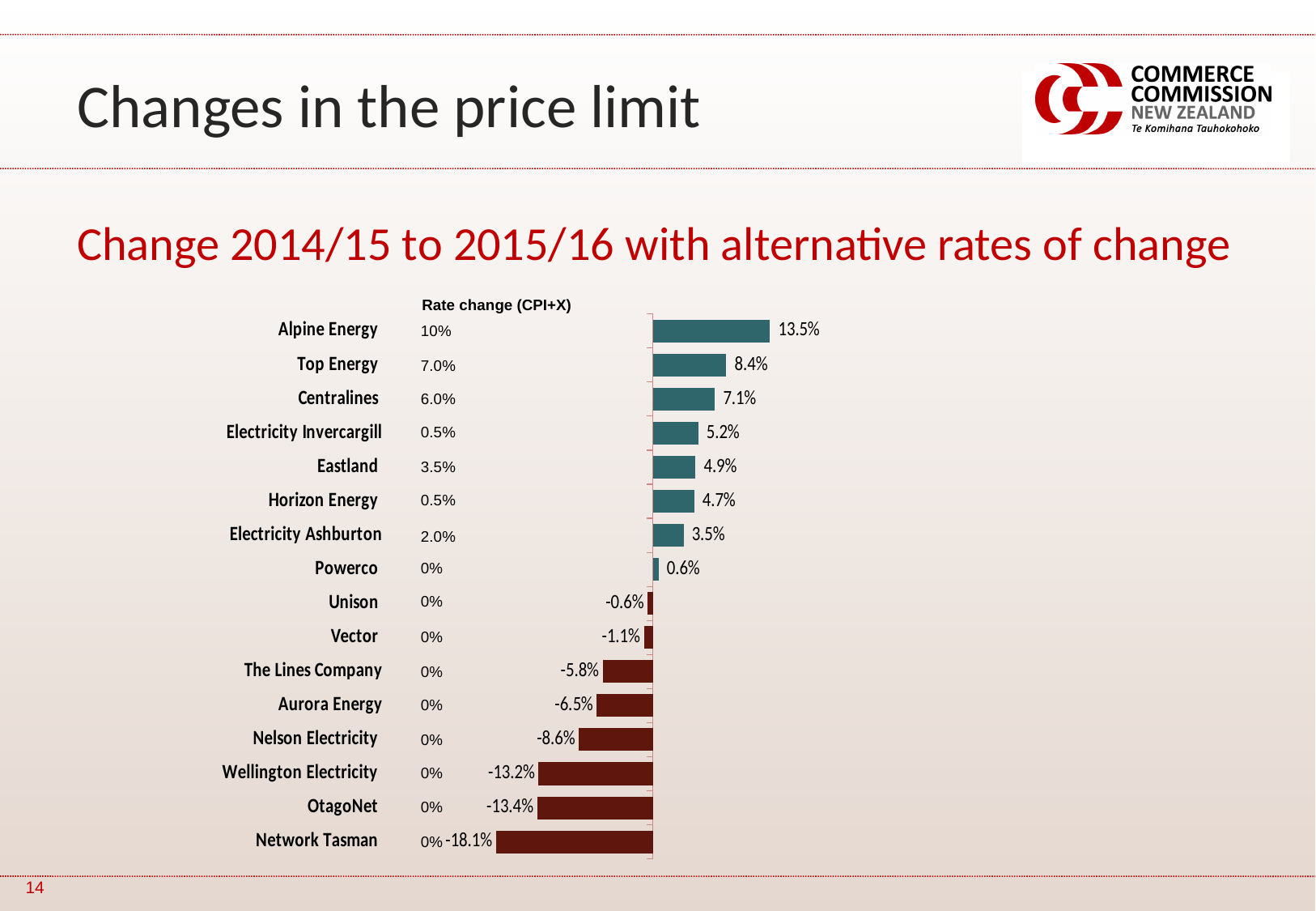
What is the change value shown for Electricity Ashburton? 3.5% Which company has the highest change value in the chart? Alpine Energy How many companies are shown in the chart? 16 What is the change value shown for Network Tasman? -18.1% What is the difference between the change values for Alpine Energy and Top Energy? 5.1 percentage points What kind of chart is shown on the slide? Bar chart What is the change value shown for Wellington Electricity? -13.2% What is the Rate change (CPI+X) listed for Alpine Energy? 10% Which has the larger change value, Eastland or Horizon Energy? Eastland Which company has the lowest change value in the chart? Network Tasman Do the change values rise or fall going down the list of companies from top to bottom? Fall What is the change value shown for Alpine Energy? 13.5%